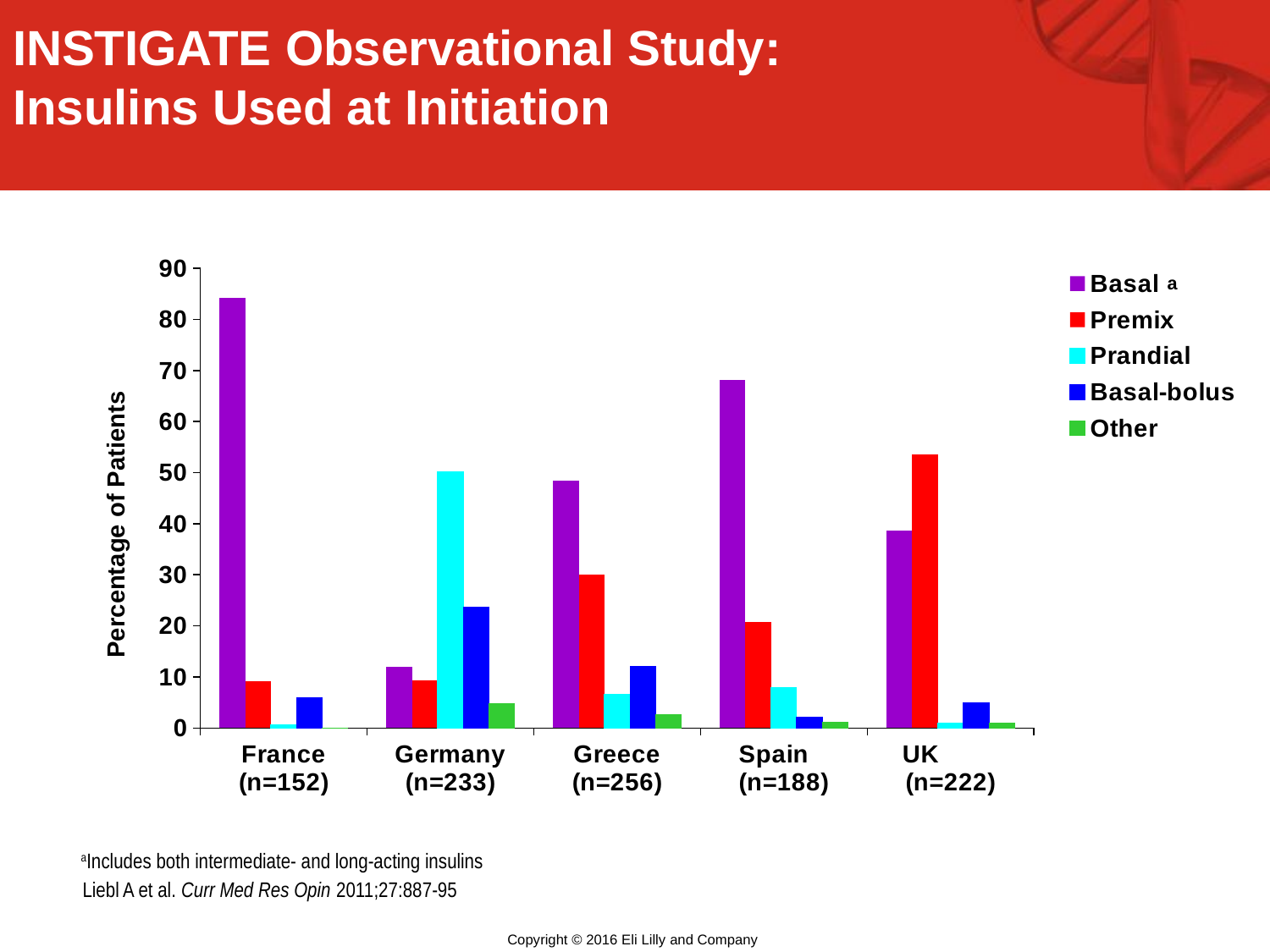
Is the Basal value for France greater or less than 80? greater Which country has the highest Basal percentage? France (n=152) Is the Premix value for Greece greater or less than 40? less In the UK, which is larger, the Basal value or the Premix value? Premix How many series does the legend list? 5 Is the Prandial value for Germany greater or less than 40? greater In Spain, which is larger, the Basal value or the Premix value? Basal What is the label of the y axis? Percentage of Patients Which country has the highest Premix percentage? UK (n=222) How many countries are shown on the x axis? 5 Which country has the highest Prandial percentage? Germany (n=233) What type of chart is shown on the slide? bar chart